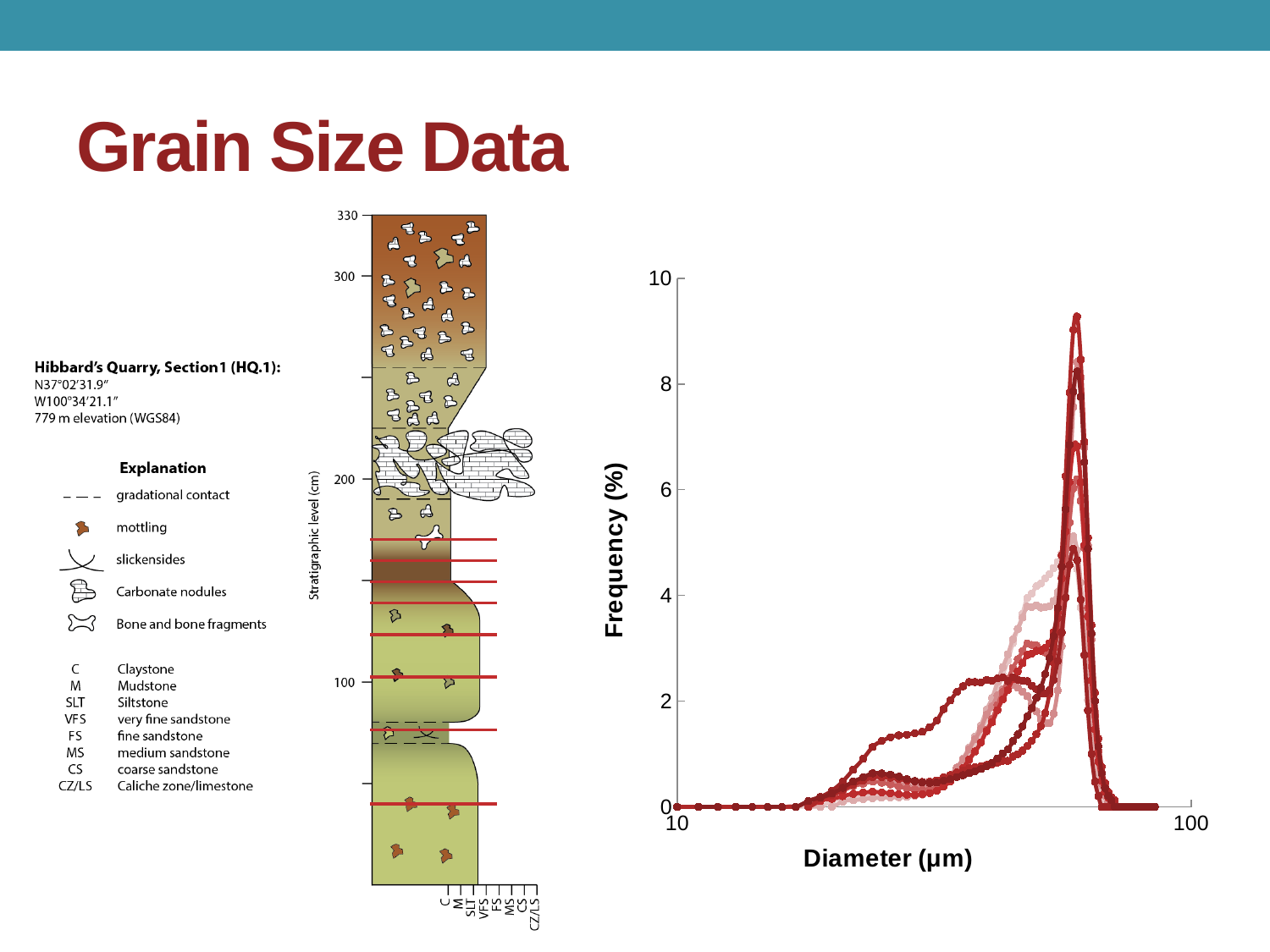
On the grain size chart, is the frequency at a diameter of 100 µm greater or less than 2? less What is the label of the vertical axis on the grain size chart? Frequency (%) On the grain size chart, do the curves rise or fall as diameter increases beyond the main peak toward 100 µm? fall On the grain size chart, is the frequency at a diameter of 10 µm greater or less than 2? less What kind of chart is the Frequency (%) versus Diameter (µm) chart on the right of the slide? line chart On the grain size chart, is the highest peak frequency greater or less than 10? less On the grain size chart, do the curves rise or fall as diameter increases from 10 µm toward the main peak? rise What is the label of the horizontal axis on the grain size chart? Diameter (µm)